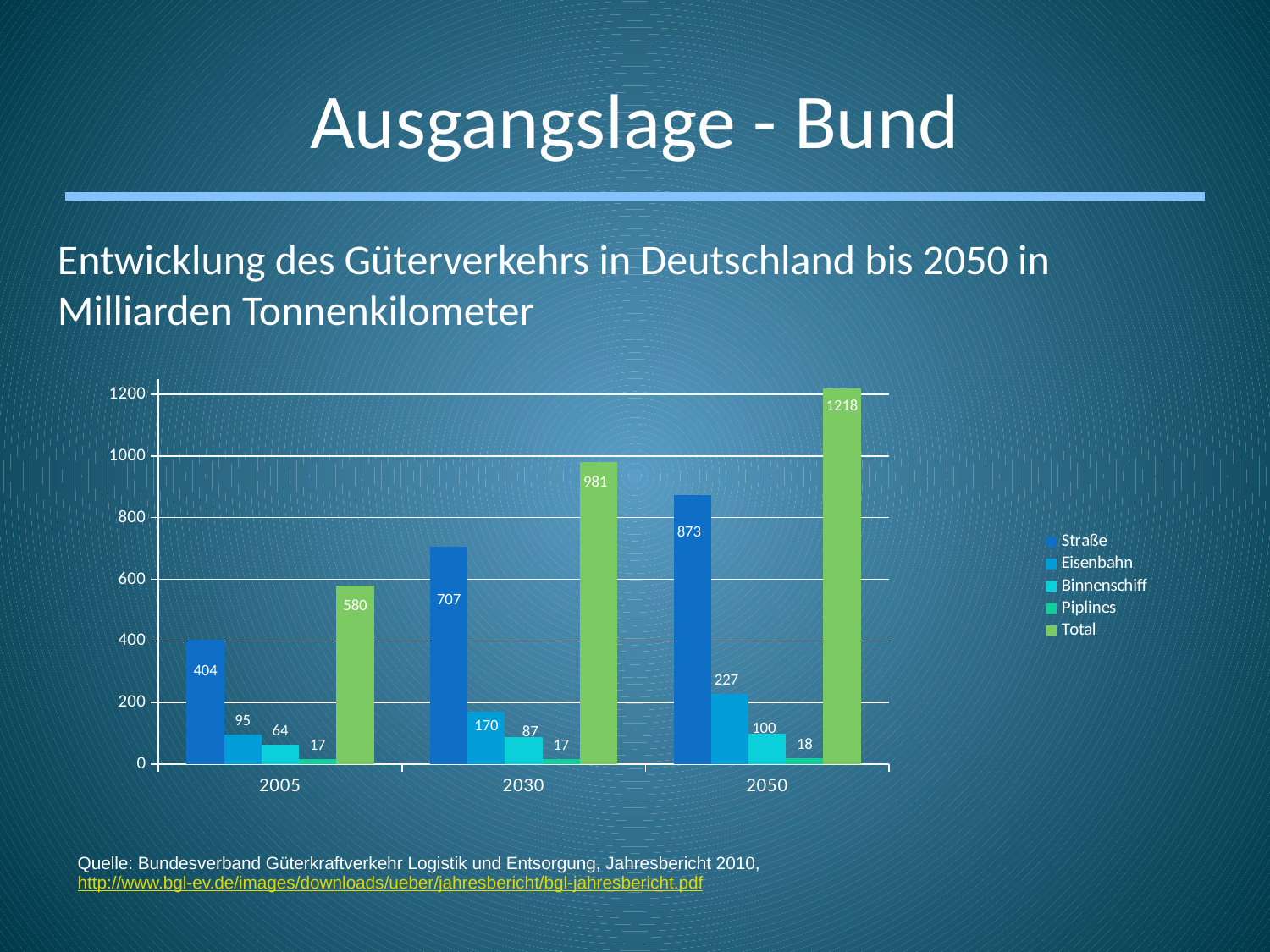
What is the value for Straße in 2050? 873 What is the value for Eisenbahn in 2005? 95 In which year is the Total value highest? 2050 How many years are shown on the x axis? 3 What kind of chart is shown on the slide? Bar chart In which year is the Straße value lowest? 2005 What is the difference between the Total values for 2050 and 2005? 638 Does the Straße value rise or fall from 2005 to 2050? Rise How many series does the legend list? 5 Which is larger: Eisenbahn in 2050 or Binnenschiff in 2050? Eisenbahn in 2050 What is the value for Binnenschiff in 2030? 87 What is the Total value for 2030? 981